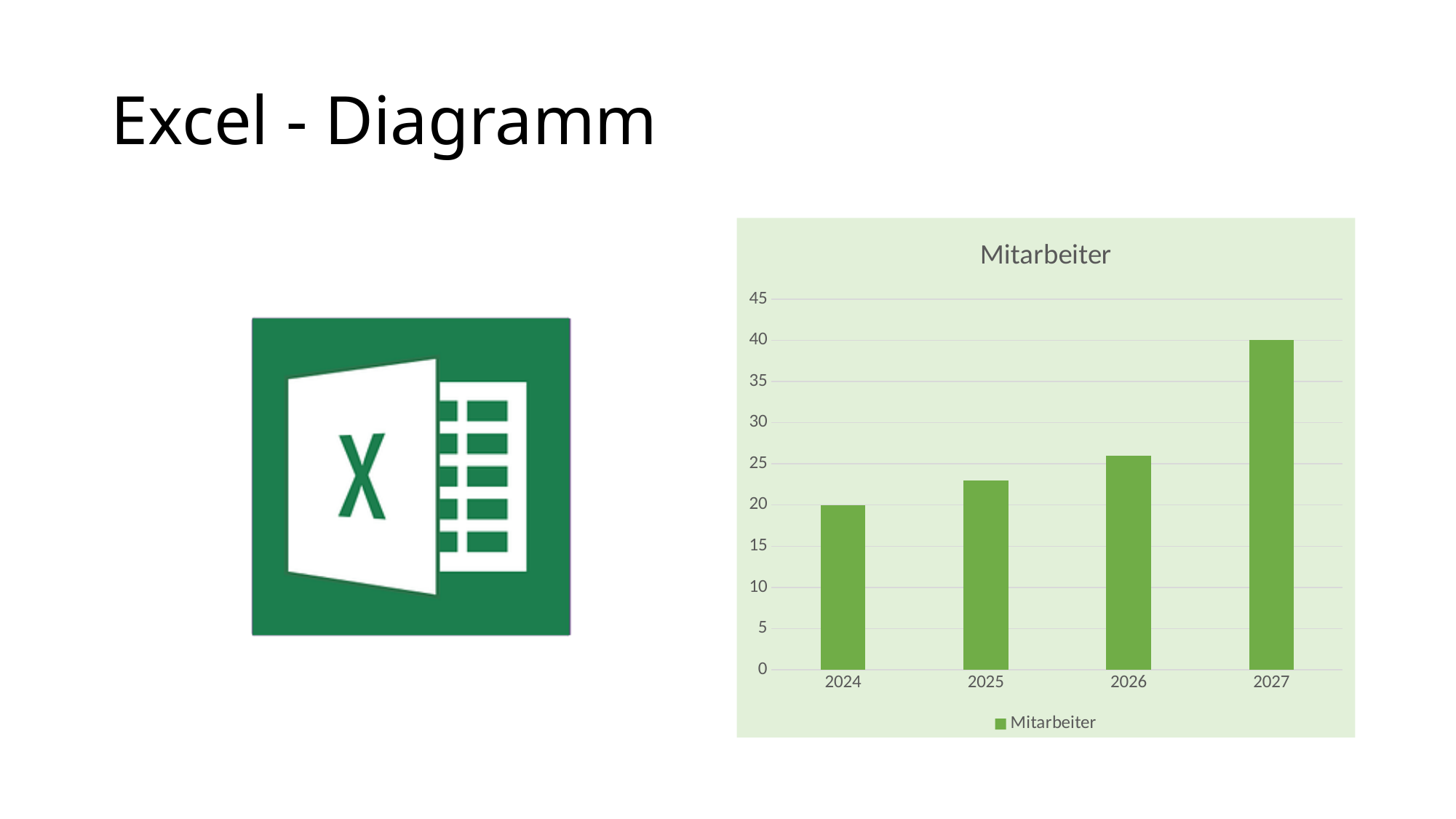
Which is larger in the Mitarbeiter chart, the value for 2025 or the value for 2027? 2027 What is the value for 2027 in the Mitarbeiter chart? 40 How many series does the legend of the Mitarbeiter chart list? 1 What is the value for 2024 in the Mitarbeiter chart? 20 What is the difference between the values for 2027 and 2024 in the Mitarbeiter chart? 20 What kind of chart is the Mitarbeiter chart? bar chart Is the value for 2025 in the Mitarbeiter chart greater or less than 25? less How many years are shown on the x axis of the Mitarbeiter chart? 4 Do the values in the Mitarbeiter chart rise or fall from 2024 to 2027? rise Which year has the lowest value in the Mitarbeiter chart? 2024 Which year has the highest value in the Mitarbeiter chart? 2027